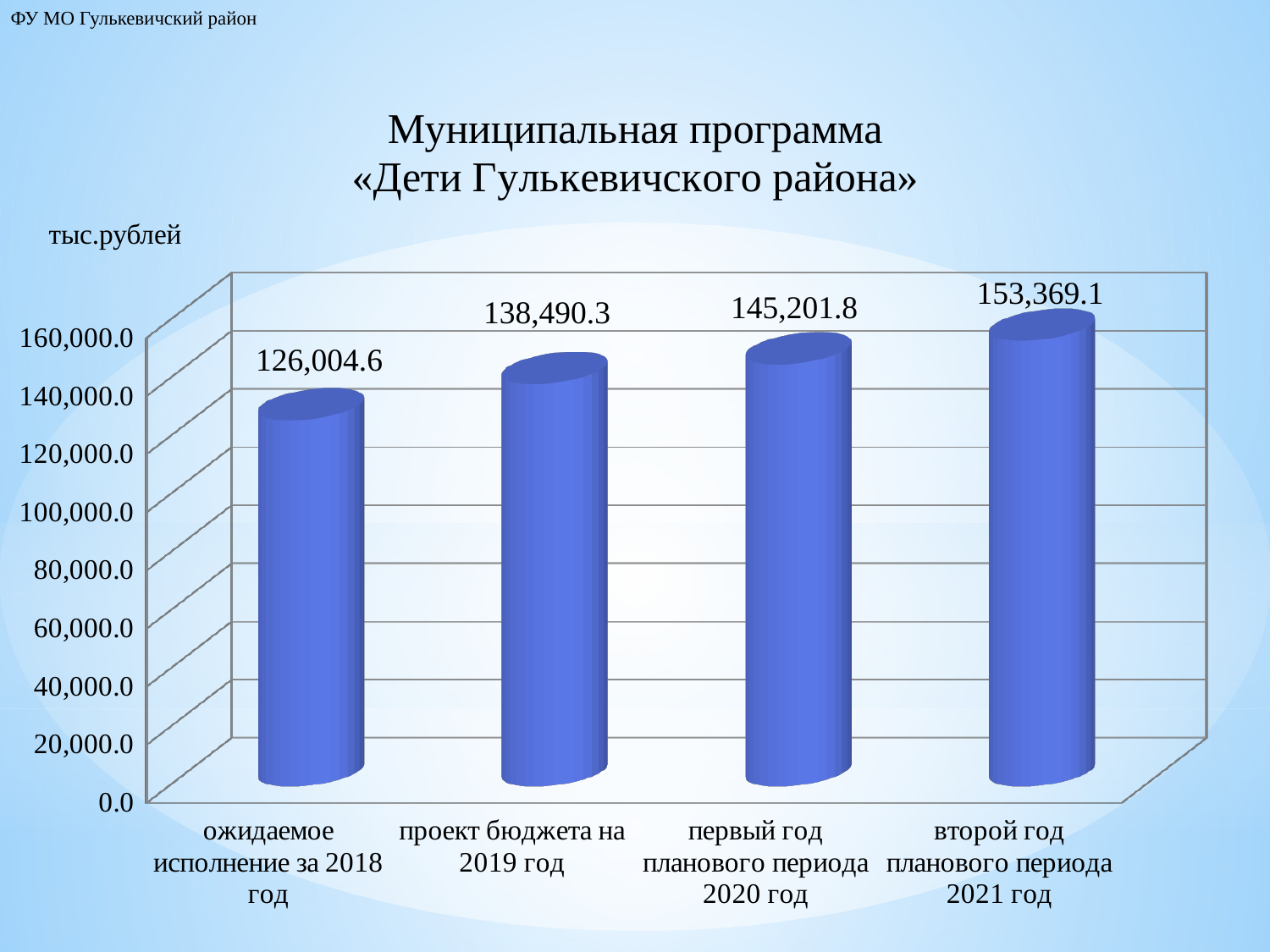
Which category has the highest value? второй год планового периода 2021 год Which category has the lowest value? ожидаемое исполнение за 2018 год How many categories are shown on the chart? 4 What kind of chart is shown on the slide? bar chart What is the value for 'второй год планового периода 2021 год'? 153,369.1 What is the value for 'ожидаемое исполнение за 2018 год'? 126,004.6 What is the value for 'первый год планового периода 2020 год'? 145,201.8 Do the values rise or fall from left to right along the x axis? rise What is the difference between the values for 2021 and 2018? 27,364.5 What is the difference between the values for 2019 and 2018? 12,485.7 Which is larger: the value for 2020 or the value for 2019? 2020 What is the value for 'проект бюджета на 2019 год'? 138,490.3